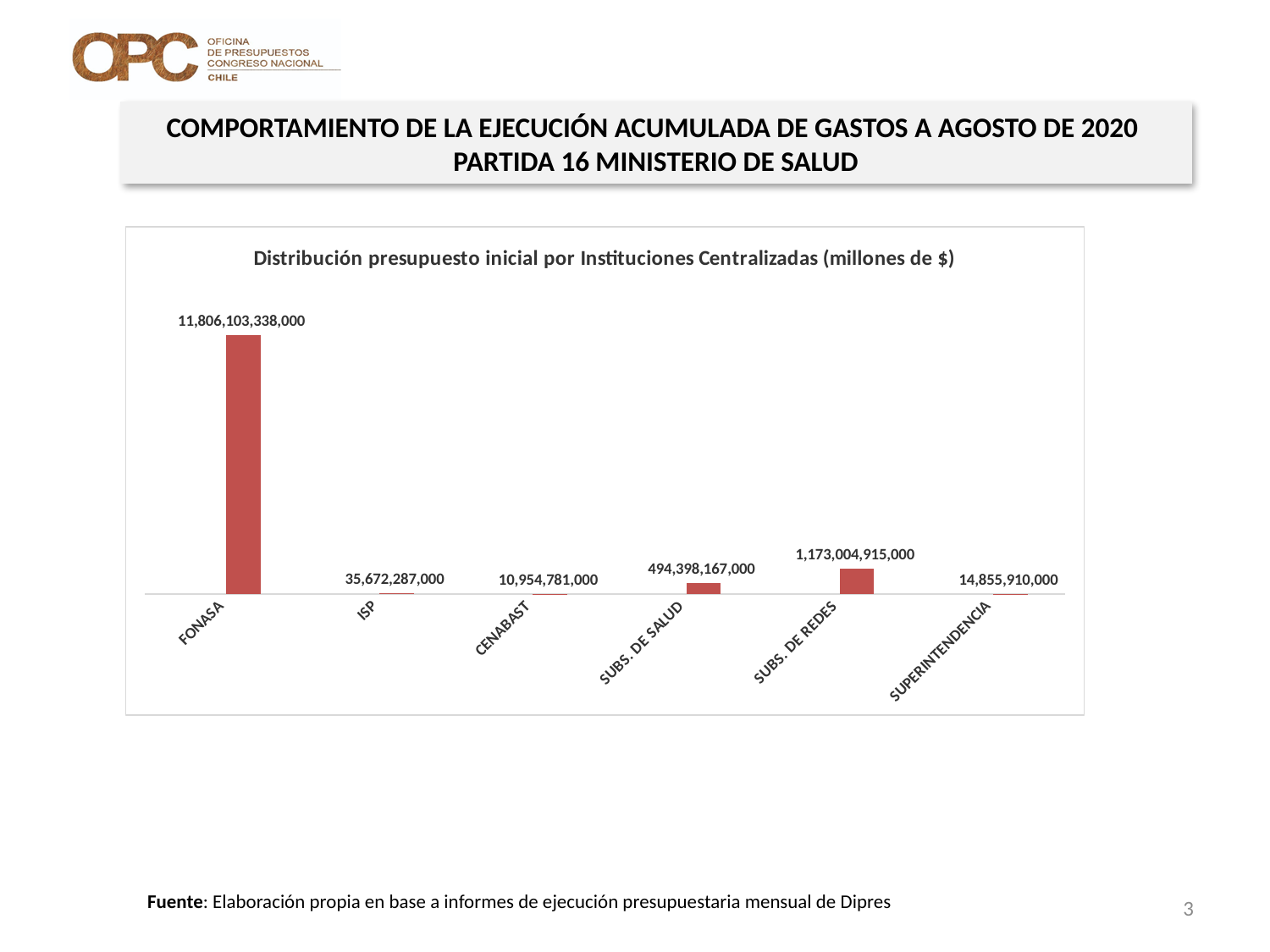
What is the difference between the values for SUBS. DE REDES and SUBS. DE SALUD? 678,606,748,000 Which is larger, the value for ISP or the value for SUPERINTENDENCIA? ISP What is the value for SUBS. DE REDES? 1,173,004,915,000 What is the value for SUPERINTENDENCIA? 14,855,910,000 What is the value for CENABAST? 10,954,781,000 Which institution has the lowest value? CENABAST What is the difference between the values for ISP and CENABAST? 24,717,506,000 How many institutions are shown in the chart? 6 What is the value for FONASA? 11,806,103,338,000 What kind of chart is shown on the slide? Bar chart What is the title of the chart? Distribución presupuesto inicial por Instituciones Centralizadas (millones de $) Which institution has the highest value? FONASA